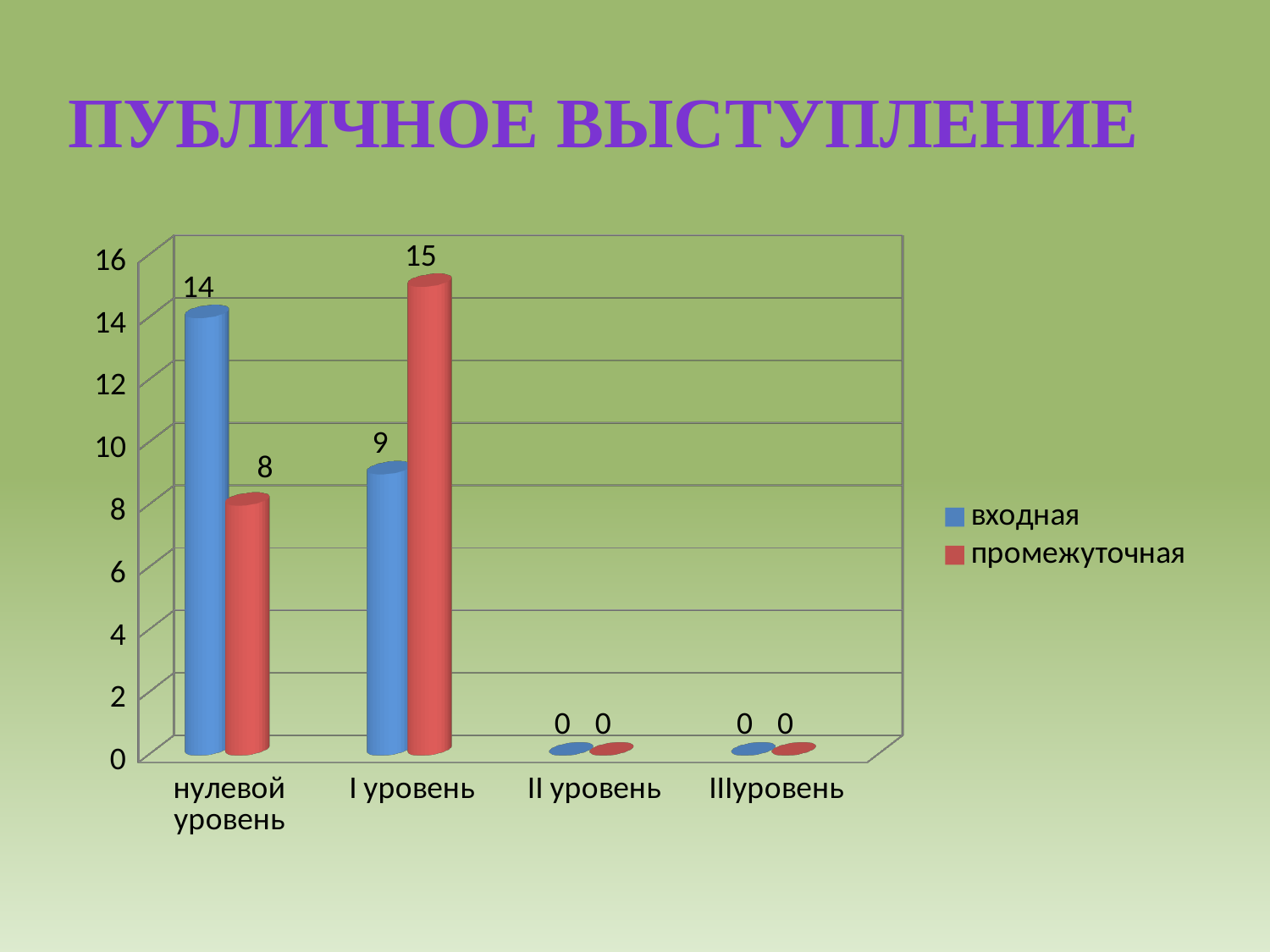
What kind of chart is shown on the slide? bar chart What is the value for входная at нулевой уровень? 14 Which is larger at I уровень: входная or промежуточная? промежуточная What is the value for промежуточная at I уровень? 15 What is the value for промежуточная at нулевой уровень? 8 What is the difference between the входная and промежуточная values at нулевой уровень? 6 What is the difference between the промежуточная and входная values at I уровень? 6 How many categories are shown on the x axis? 4 How many series does the legend list? 2 Which category has the highest value for the промежуточная series? I уровень What is the value for входная at I уровень? 9 Which category has the highest value for the входная series? нулевой уровень